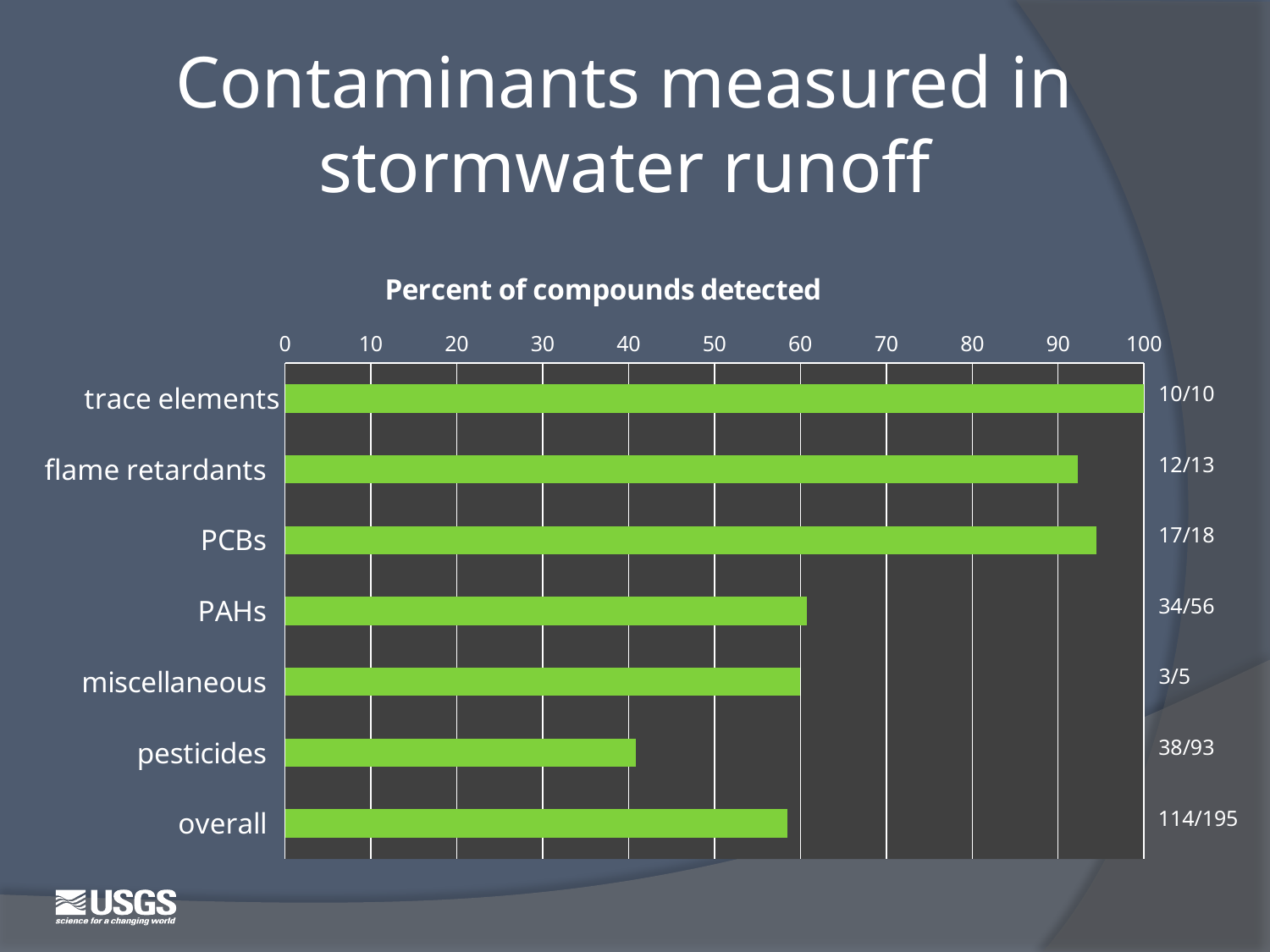
Which category has the highest percent of compounds detected? trace elements What kind of chart is shown on the slide? bar chart What is the title of the chart? Percent of compounds detected How many categories are plotted in the chart? 7 Is the value for overall greater or less than 50? greater What label is printed to the right of the overall bar? 114/195 Which has a larger percent of compounds detected, PAHs or pesticides? PAHs What is the percent of compounds detected for trace elements? 100 Is the value for pesticides greater or less than 50? less Is the value for PCBs greater or less than 90? greater What label is printed to the right of the PAHs bar? 34/56 Which category has the lowest percent of compounds detected? pesticides